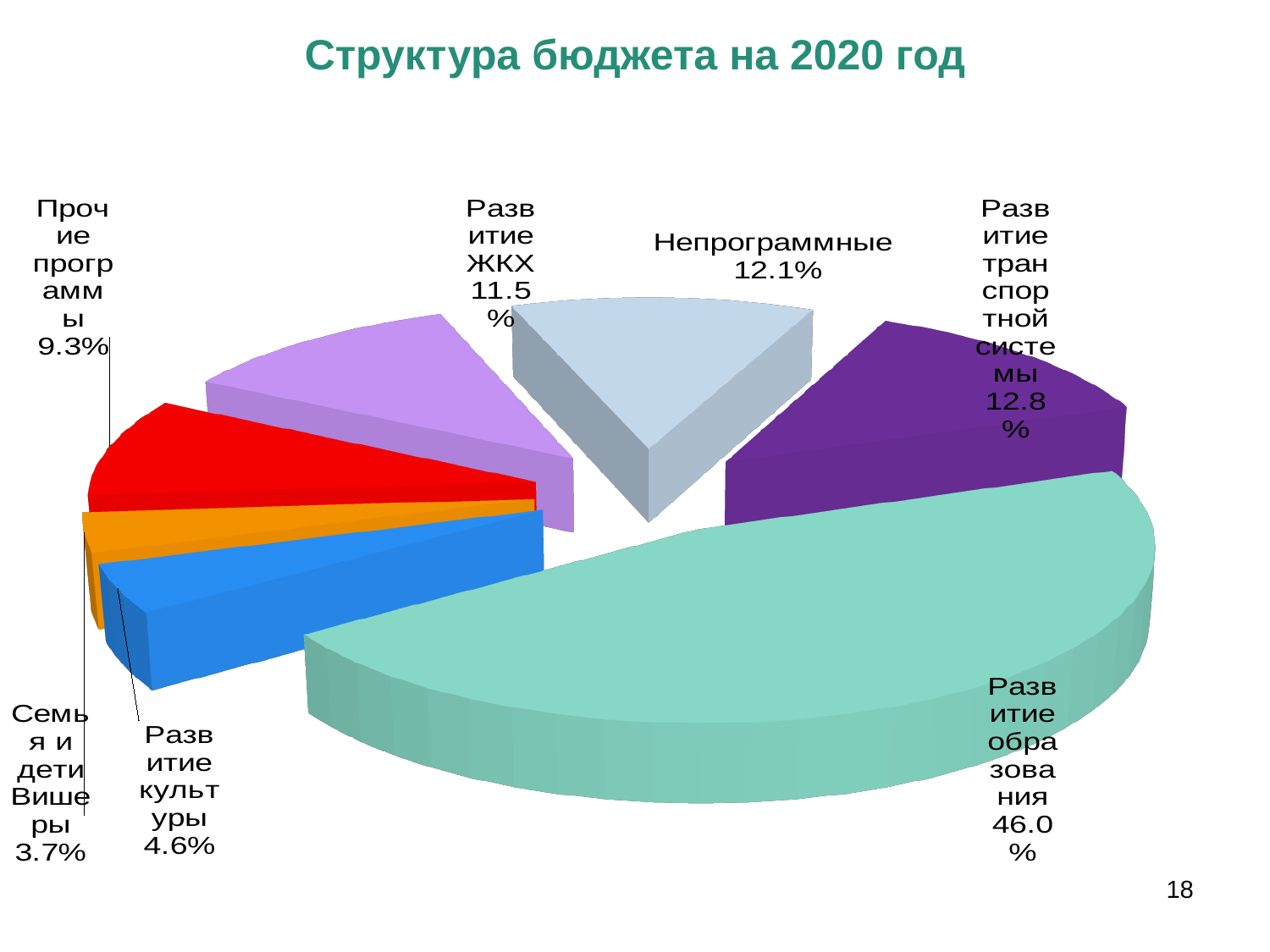
What share of the budget goes to Развитие образования? 46.0% What is the title of the chart? Структура бюджета на 2020 год What is the difference between the shares of Развитие образования and Развитие транспортной системы? 33.2% Which is larger, the share for Прочие программы or the share for Развитие культуры? Прочие программы Which category has the largest share of the budget? Развитие образования What share of the budget is labelled Непрограммные? 12.1% What share of the budget goes to Семья и дети Вишеры? 3.7% How many slices does the pie chart have? 7 What share of the budget goes to Развитие ЖКХ? 11.5% Which category has the smallest share of the budget? Семья и дети Вишеры What kind of chart is shown on the slide? pie chart What share of the budget goes to Развитие транспортной системы? 12.8%